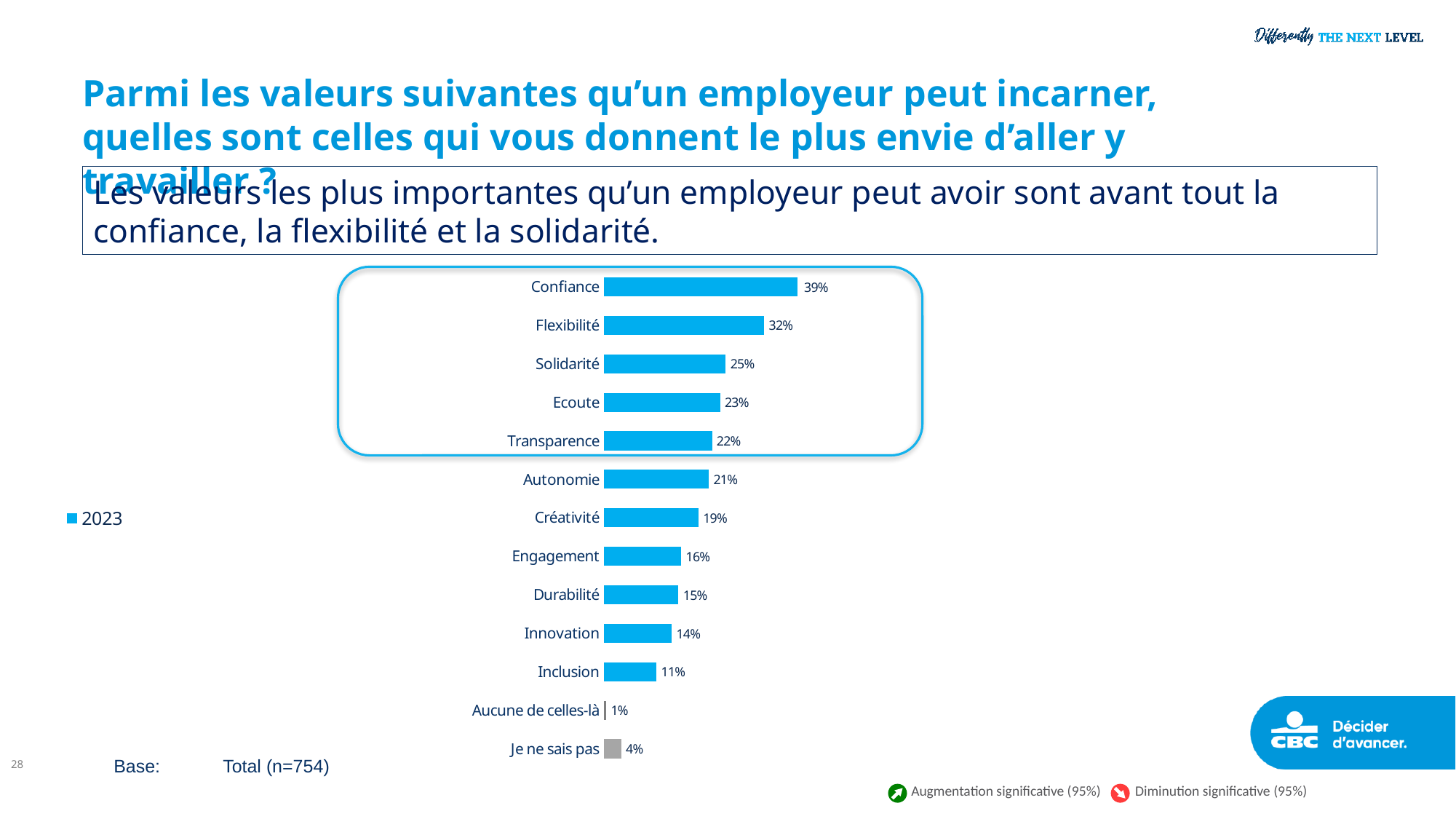
Which category has the lowest value? Aucune de celles-là What is the difference between the values for Confiance and Flexibilité? 7% What kind of chart is shown on the slide? Bar chart What is the value for Confiance? 39% Which category has the highest value? Confiance Which is larger, the value for Ecoute or the value for Autonomie? Ecoute What is the value for Inclusion? 11% What is the value for Je ne sais pas? 4% How many series does the legend list? 1 How many categories are shown in the chart? 13 What is the value for Solidarité? 25% What series name does the legend show? 2023